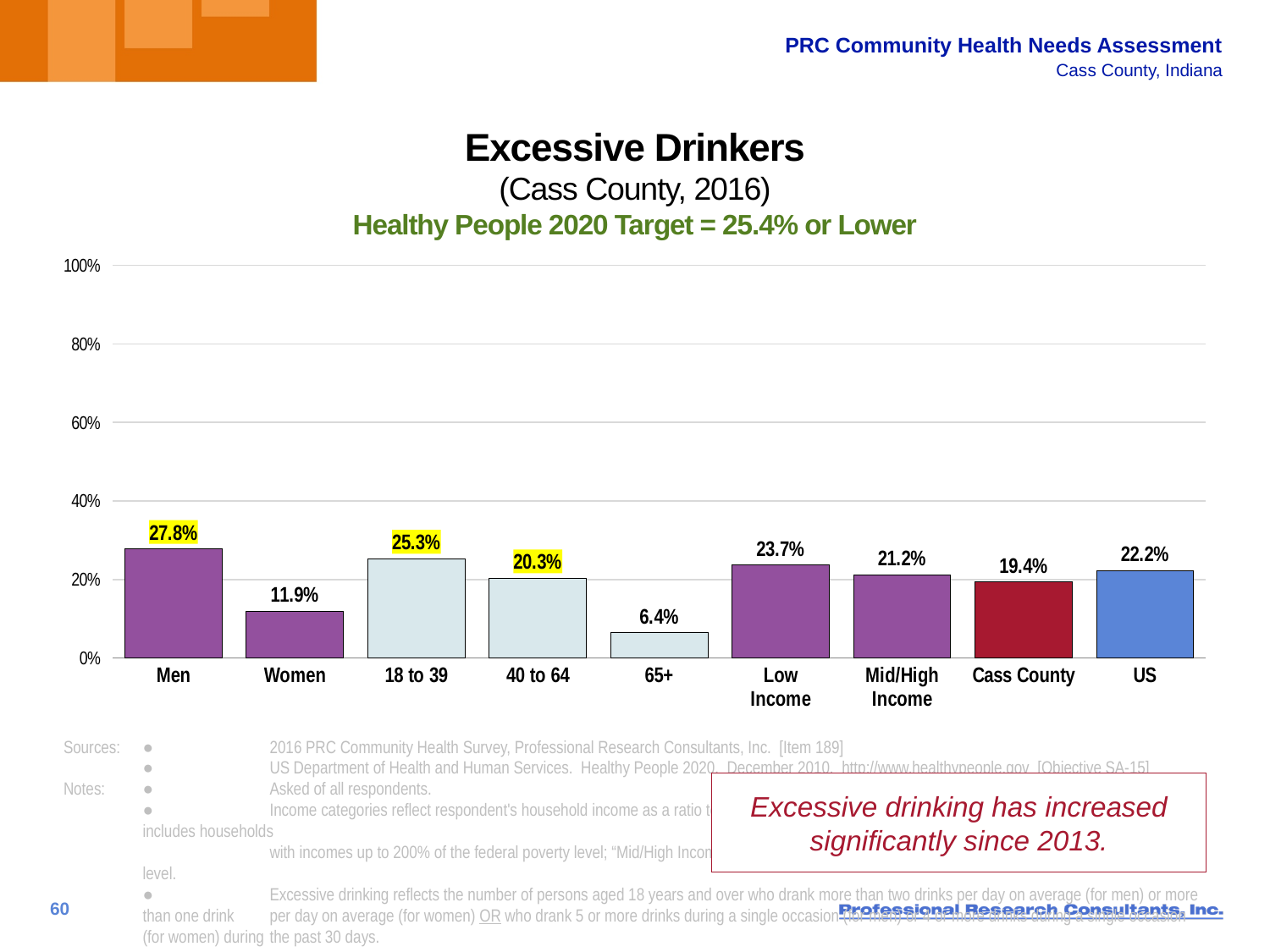
Which category has the highest value? Men What is the difference between the values for Men and Women? 15.9% Is the value for US greater or less than 40%? less Which is larger, the value for Low Income or Mid/High Income? Low Income What is the value for the 65+ age group? 6.4% Which category has the lowest value? 65+ What is the value for Men? 27.8% What is the Healthy People 2020 Target stated in the chart subtitle? 25.4% or Lower How many categories are shown on the x axis? 9 What is the value for Cass County? 19.4% What kind of chart is shown? bar chart What is the value for Women? 11.9%